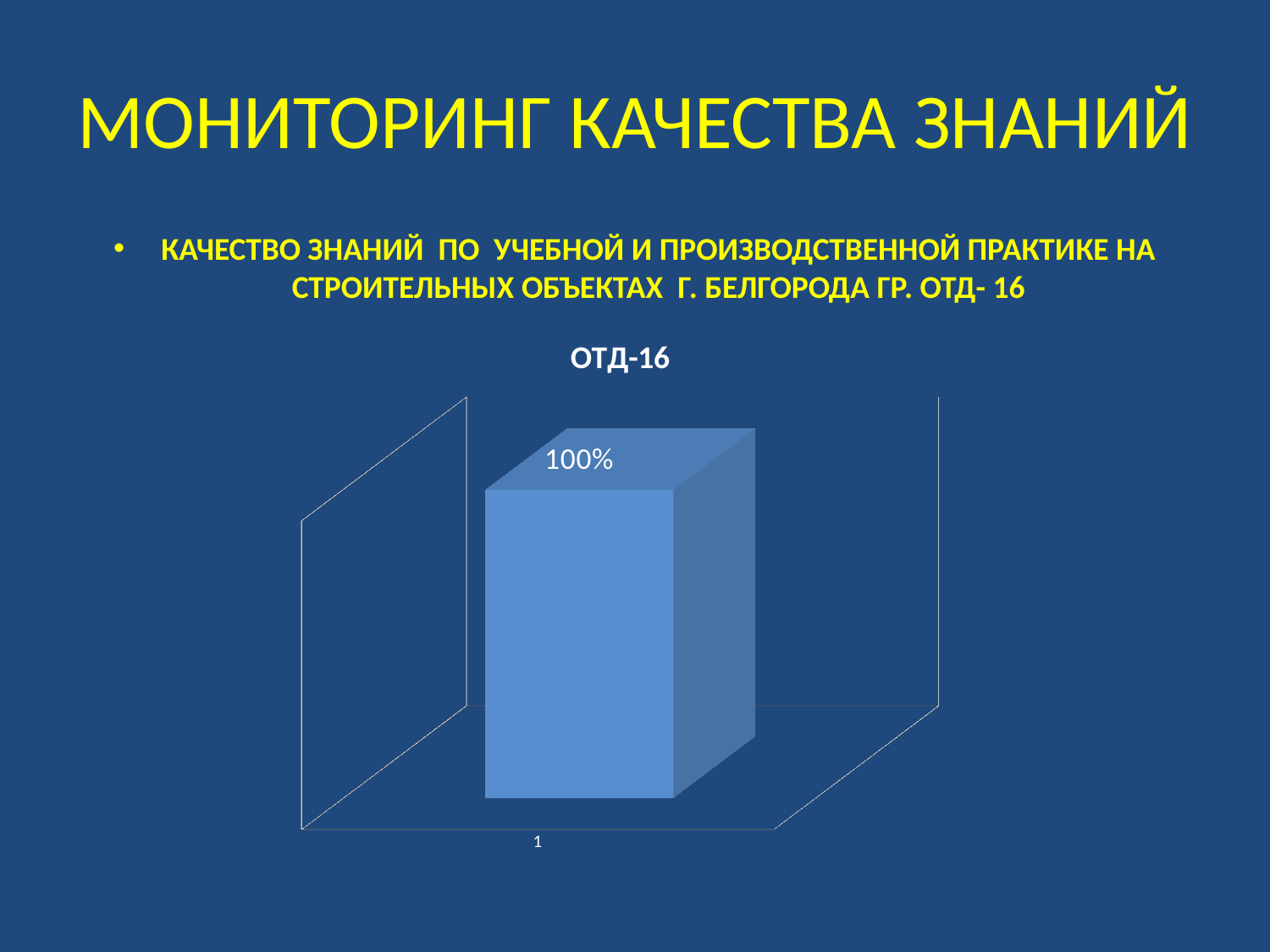
What is the value shown on the bar labelled 1? 100% What is the title of the chart? ОТД-16 What type of chart is shown on the slide? bar chart How many bars does the chart show? 1 What is the category label shown on the x axis? 1